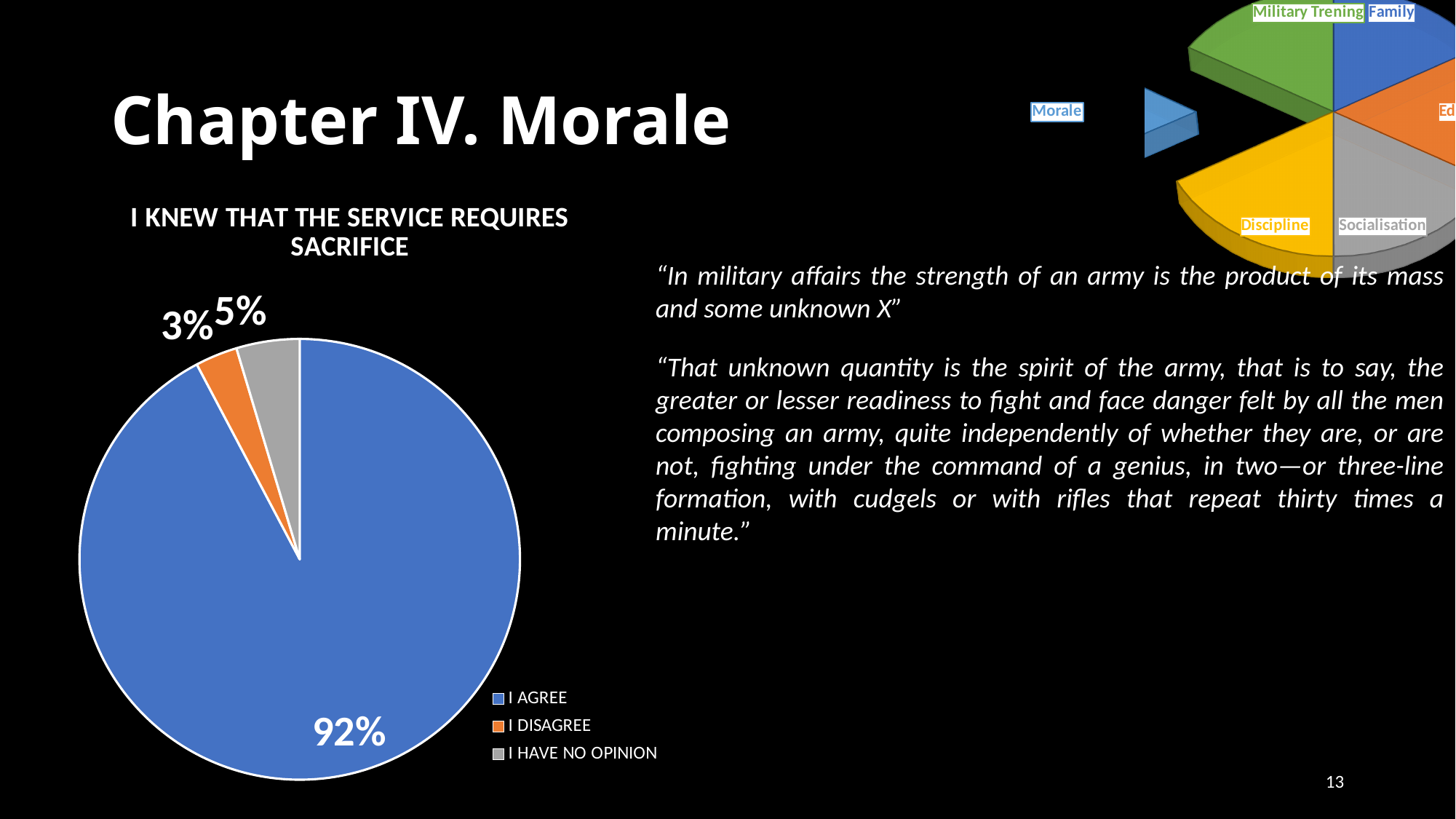
In the chart titled "I KNEW THAT THE SERVICE REQUIRES SACRIFICE", what is the difference in percentage points between "I HAVE NO OPINION" and "I DISAGREE"? 2 What type of chart is the chart titled "I KNEW THAT THE SERVICE REQUIRES SACRIFICE"? Pie chart In the chart titled "I KNEW THAT THE SERVICE REQUIRES SACRIFICE", which response has the smallest share? I DISAGREE In the chart titled "I KNEW THAT THE SERVICE REQUIRES SACRIFICE", how many response categories are shown in the legend? 3 In the chart titled "I KNEW THAT THE SERVICE REQUIRES SACRIFICE", what percentage of respondents chose "I HAVE NO OPINION"? 5% In the chart titled "I KNEW THAT THE SERVICE REQUIRES SACRIFICE", which response has the largest share? I AGREE In the chart titled "I KNEW THAT THE SERVICE REQUIRES SACRIFICE", which is larger: the share for "I DISAGREE" or the share for "I HAVE NO OPINION"? I HAVE NO OPINION In the chart titled "I KNEW THAT THE SERVICE REQUIRES SACRIFICE", what percentage of respondents chose "I DISAGREE"? 3% In the chart titled "I KNEW THAT THE SERVICE REQUIRES SACRIFICE", what colour is the "I DISAGREE" slice? Orange In the chart titled "I KNEW THAT THE SERVICE REQUIRES SACRIFICE", what colour is the "I AGREE" slice? Blue In the chart titled "I KNEW THAT THE SERVICE REQUIRES SACRIFICE", what is the difference in percentage points between "I AGREE" and "I HAVE NO OPINION"? 87 In the chart titled "I KNEW THAT THE SERVICE REQUIRES SACRIFICE", what percentage of respondents chose "I AGREE"? 92%